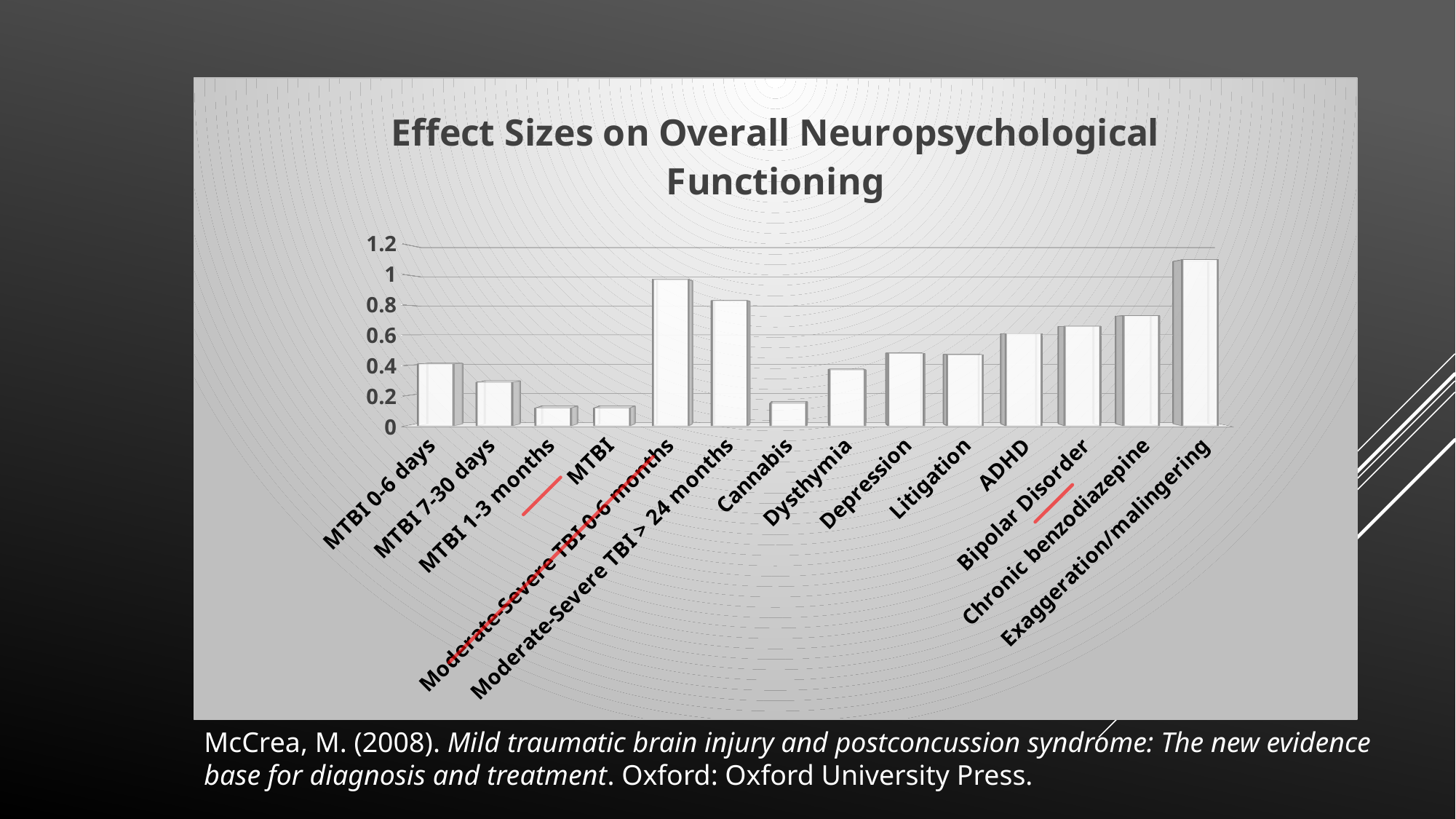
Is the value for MTBI 7-30 days greater or less than 0.4? less Which is larger, the value for Moderate-Severe TBI 0-6 months or Moderate-Severe TBI > 24 months? Moderate-Severe TBI 0-6 months Which is larger, the value for Cannabis or Dysthymia? Dysthymia Is the value for Cannabis greater or less than 0.2? less How many categories are plotted on the x axis? 14 Is the value for Chronic benzodiazepine greater or less than 0.6? greater Which category has the highest effect size? Exaggeration/malingering What is the title of the chart? Effect Sizes on Overall Neuropsychological Functioning What is the highest value shown on the y axis? 1.2 What kind of chart is shown on the slide? bar chart